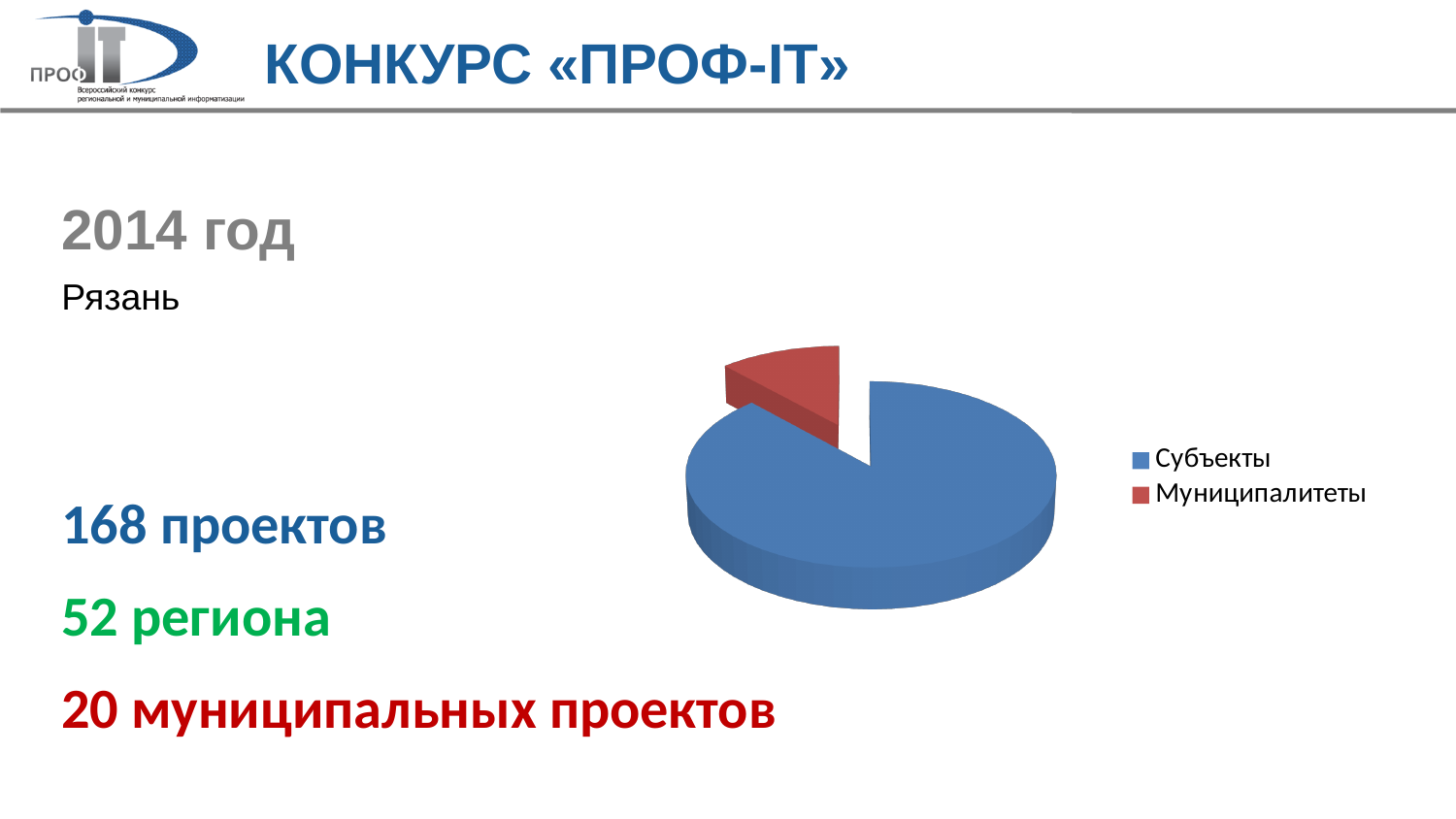
How many slices does the pie chart have? 2 What colour is the Субъекты slice in the pie chart? blue What colour is the Муниципалитеты slice in the pie chart? red What kind of chart is shown on the slide? pie chart How many entries does the legend of the pie chart list? 2 Which category has the smallest slice in the pie chart? Муниципалитеты Which category has the largest slice in the pie chart? Субъекты Which slice is larger in the pie chart, Субъекты or Муниципалитеты? Субъекты